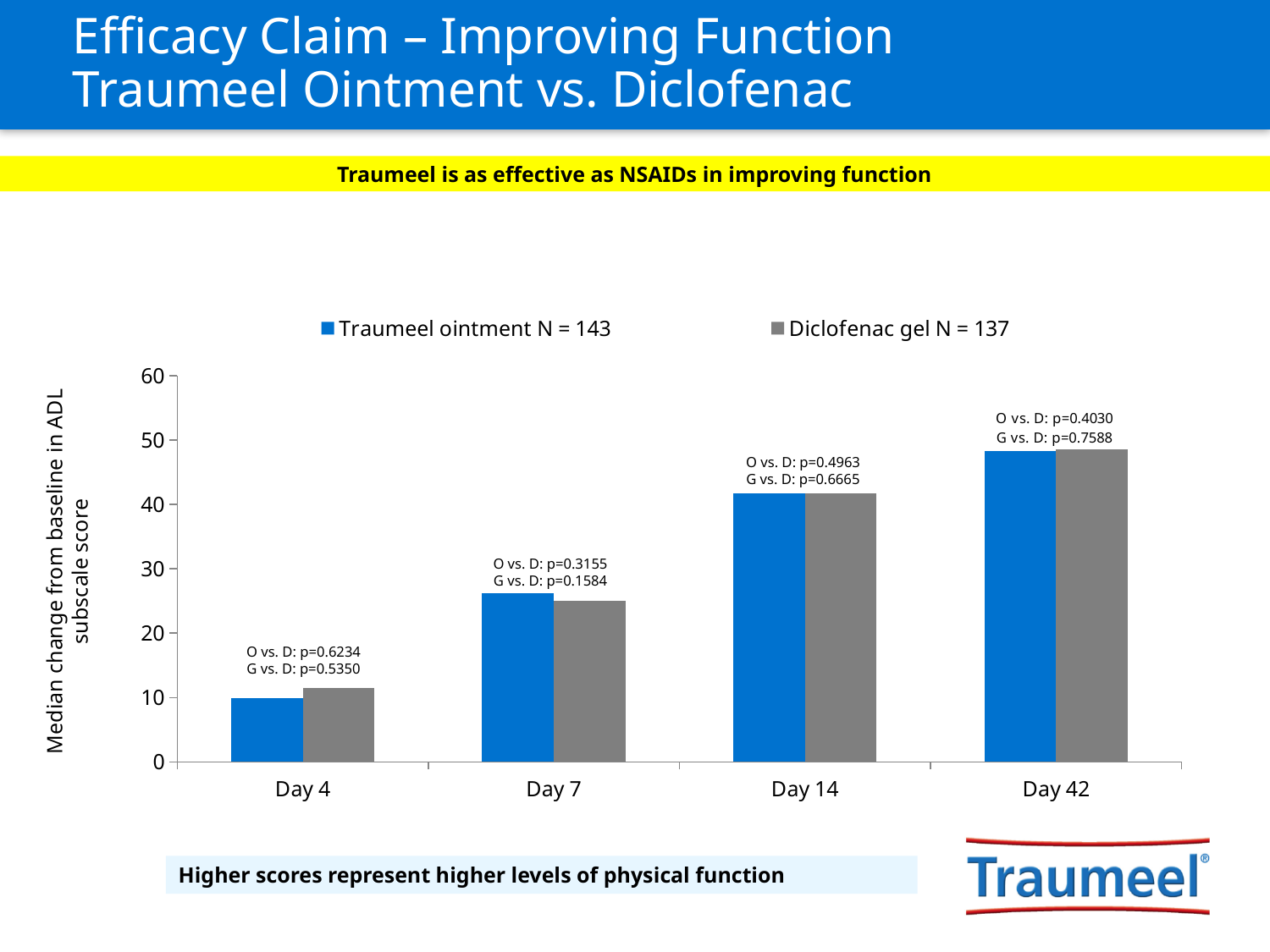
Do the Traumeel ointment values rise or fall from Day 4 to Day 42? Rise Is the Traumeel ointment value at Day 4 greater or less than 20? less What kind of chart is shown on the slide? Bar chart How many time points (categories) are shown on the x axis? 4 Which is larger for Diclofenac gel: the value at Day 7 or the value at Day 14? Day 14 Is the Traumeel ointment value at Day 42 greater or less than 40? greater Is the Diclofenac gel value at Day 14 greater or less than 30? greater What is the label of the y axis? Median change from baseline in ADL subscale score How many series does the legend list? 2 At which day is the Traumeel ointment bar highest? Day 42 What is the O vs. D p-value printed above the Day 4 bars? p=0.6234 At which day is the Diclofenac gel bar lowest? Day 4